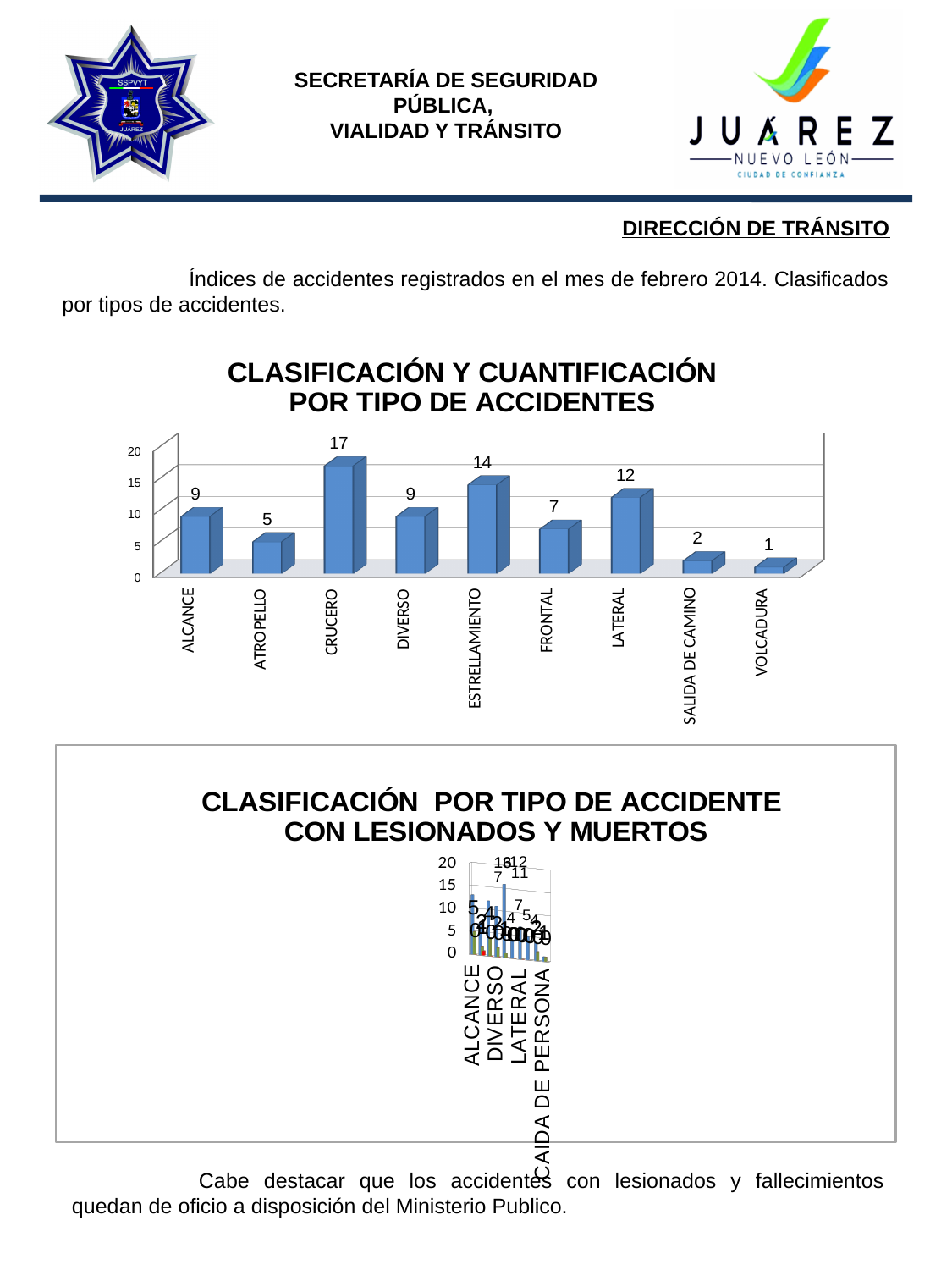
In the chart titled 'CLASIFICACIÓN Y CUANTIFICACIÓN POR TIPO DE ACCIDENTES', what is the value for ATROPELLO? 5 In the chart titled 'CLASIFICACIÓN Y CUANTIFICACIÓN POR TIPO DE ACCIDENTES', what is the difference between the values for CRUCERO and LATERAL? 5 In the chart titled 'CLASIFICACIÓN Y CUANTIFICACIÓN POR TIPO DE ACCIDENTES', what is the value for SALIDA DE CAMINO? 2 In the chart titled 'CLASIFICACIÓN Y CUANTIFICACIÓN POR TIPO DE ACCIDENTES', what is the value for ESTRELLAMIENTO? 14 In the chart titled 'CLASIFICACIÓN Y CUANTIFICACIÓN POR TIPO DE ACCIDENTES', what is the value for CRUCERO? 17 How many categories are shown in the chart titled 'CLASIFICACIÓN Y CUANTIFICACIÓN POR TIPO DE ACCIDENTES'? 9 In the chart titled 'CLASIFICACIÓN Y CUANTIFICACIÓN POR TIPO DE ACCIDENTES', what is the difference between the values for ESTRELLAMIENTO and FRONTAL? 7 In the chart titled 'CLASIFICACIÓN Y CUANTIFICACIÓN POR TIPO DE ACCIDENTES', is the value for FRONTAL greater or less than 10? less In the chart titled 'CLASIFICACIÓN Y CUANTIFICACIÓN POR TIPO DE ACCIDENTES', which category has the highest value? CRUCERO In the chart titled 'CLASIFICACIÓN Y CUANTIFICACIÓN POR TIPO DE ACCIDENTES', which is larger, the value for LATERAL or the value for ALCANCE? LATERAL What kind of chart is the one titled 'CLASIFICACIÓN Y CUANTIFICACIÓN POR TIPO DE ACCIDENTES'? Bar chart In the chart titled 'CLASIFICACIÓN Y CUANTIFICACIÓN POR TIPO DE ACCIDENTES', which category has the lowest value? VOLCADURA